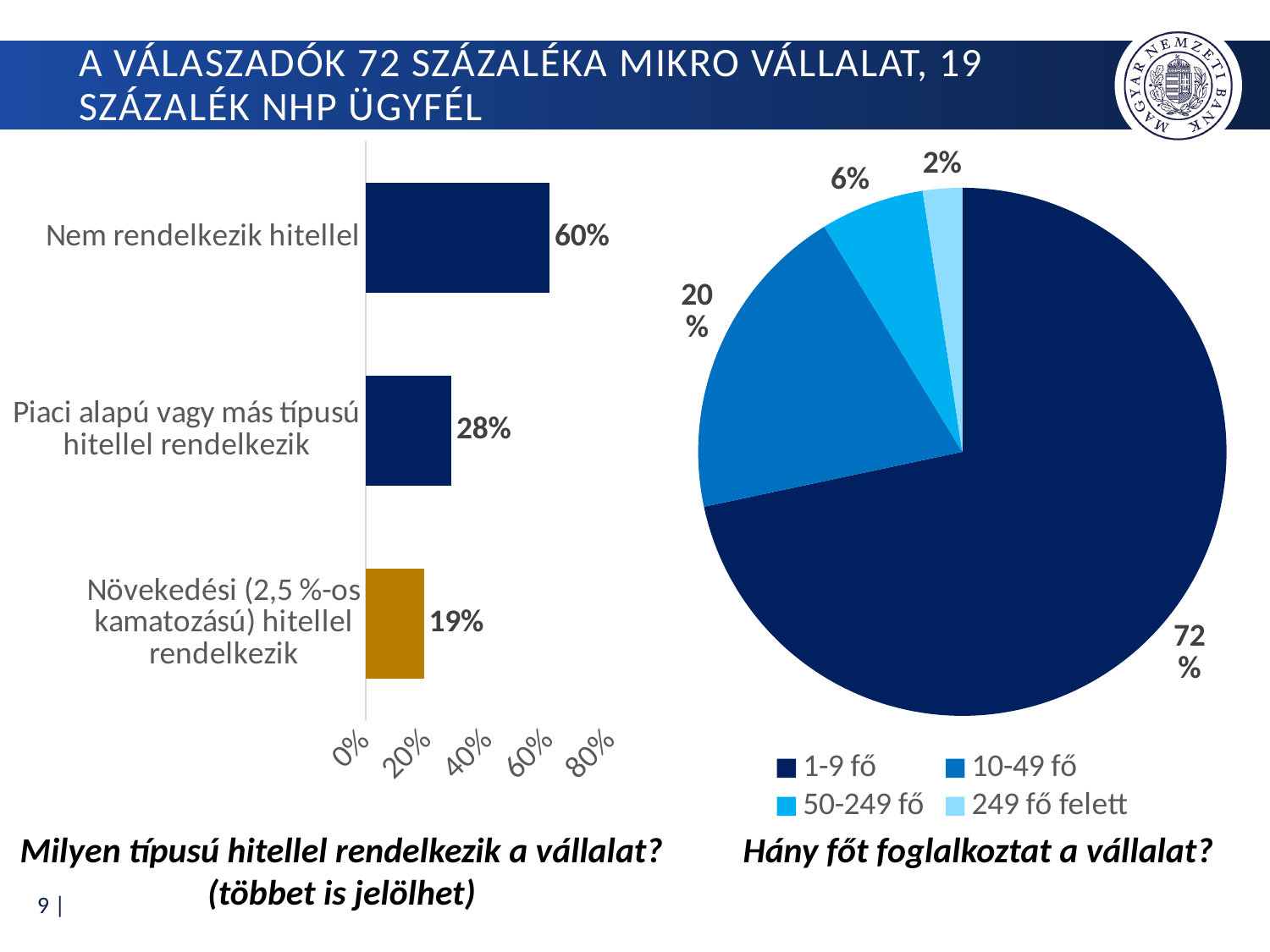
In the left bar chart, what is the value for 'Nem rendelkezik hitellel'? 60% In the pie chart on the right, what share does '10-49 fő' have? 20% In the pie chart on the right, which is larger: '50-249 fő' or '249 fő felett'? 50-249 fő In the left bar chart, what is the difference between 'Nem rendelkezik hitellel' and 'Piaci alapú vagy más típusú hitellel rendelkezik'? 32% In the pie chart on the right, which category has the smallest slice? 249 fő felett In the pie chart on the right, how many categories does the legend list? 4 In the left bar chart, what is the value for 'Piaci alapú vagy más típusú hitellel rendelkezik'? 28% In the left bar chart, how many categories are shown? 3 What kind of chart is the chart on the right side of the slide? pie chart What kind of chart is the chart on the left side of the slide? bar chart In the left bar chart, which category has the lowest value? Növekedési (2,5 %-os kamatozású) hitellel rendelkezik In the pie chart on the right, what share does '1-9 fő' have? 72%